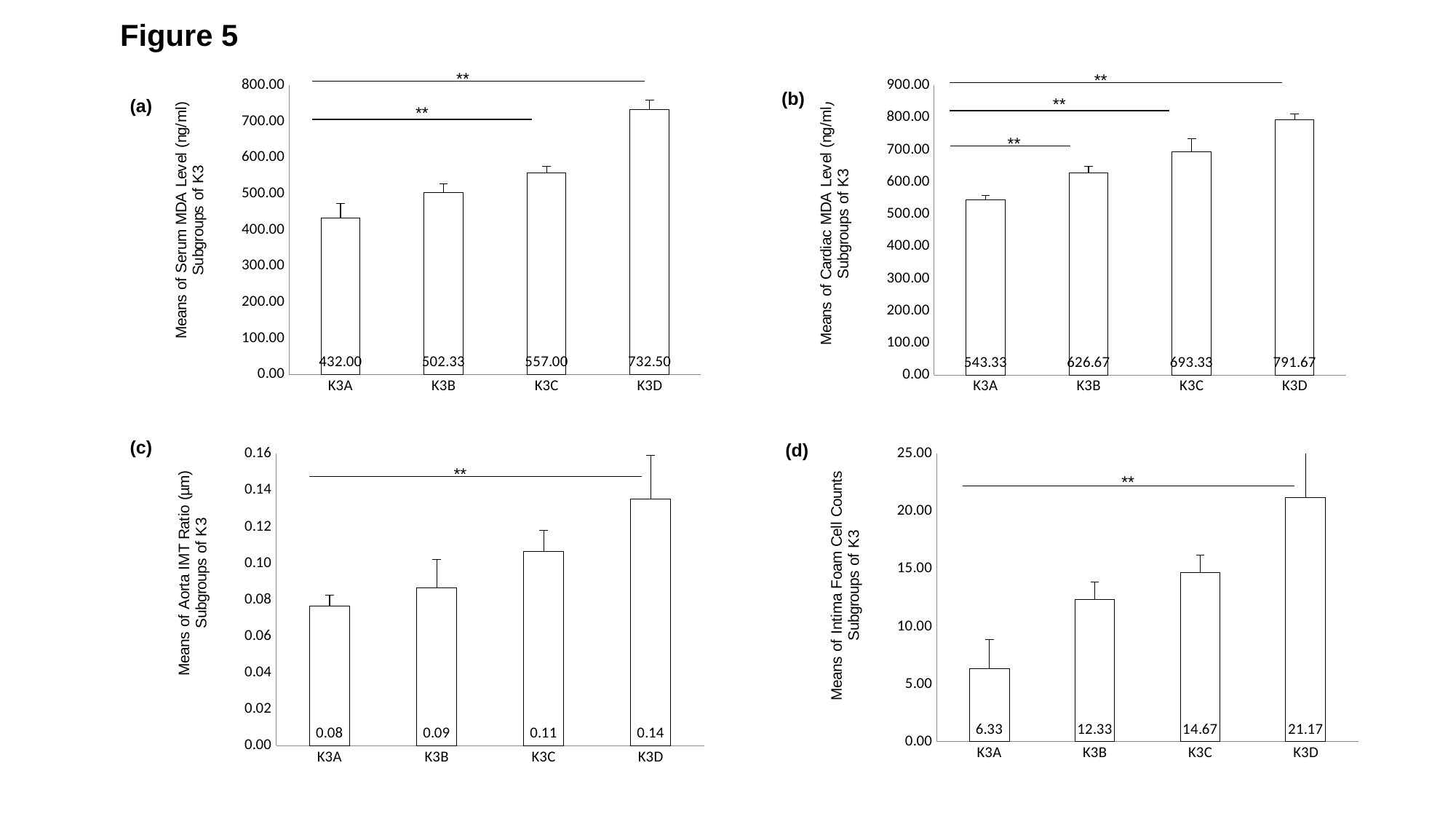
What kind of chart is chart (a), Means of Serum MDA Level? bar chart In chart (d), Means of Intima Foam Cell Counts, which subgroup has the lowest value? K3A In chart (b), Means of Cardiac MDA Level, what is the value for K3B? 626.67 In chart (b), Means of Cardiac MDA Level, which subgroup has the highest value? K3D How many subgroups are shown on the x axis of chart (d), Means of Intima Foam Cell Counts? 4 In chart (d), Means of Intima Foam Cell Counts, what is the difference between the values for K3C and K3B? 2.34 In chart (d), Means of Intima Foam Cell Counts, do the values rise or fall from K3A to K3D? rise In chart (b), Means of Cardiac MDA Level, is the value for K3A greater or less than 600.00? less In chart (c), Means of Aorta IMT Ratio, what is the value for K3B? 0.09 In chart (a), Means of Serum MDA Level, what is the difference between the values for K3D and K3A? 300.50 In chart (c), Means of Aorta IMT Ratio, is the value for K3C larger or smaller than the value for K3A? larger In chart (a), Means of Serum MDA Level, what is the value for K3C? 557.00